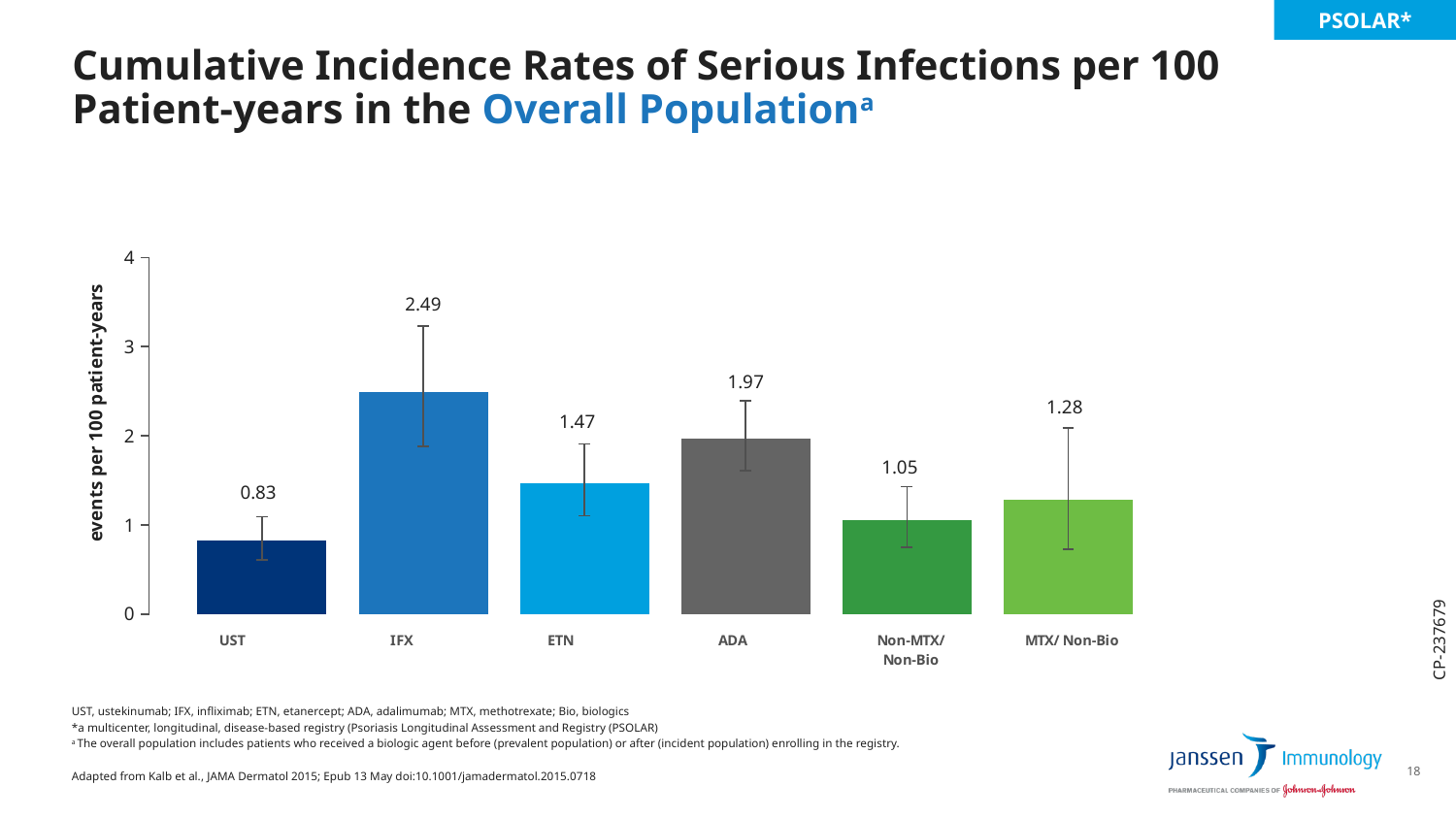
What is the value shown for IFX? 2.49 Which has a higher value, ADA or Non-MTX/Non-Bio? ADA What is the label of the y axis? events per 100 patient-years What is the difference between the values for IFX and UST? 1.66 Which treatment group has the highest cumulative incidence rate of serious infections? IFX What is the cumulative incidence rate of serious infections per 100 patient-years for UST? 0.83 What is the difference between the values for ADA and ETN? 0.50 Is the value for IFX greater or less than 2? greater Which treatment group has the lowest cumulative incidence rate of serious infections? UST How many treatment groups are shown on the x axis? 6 What kind of chart is shown on the slide? Bar chart What is the value shown for the MTX/ Non-Bio group? 1.28